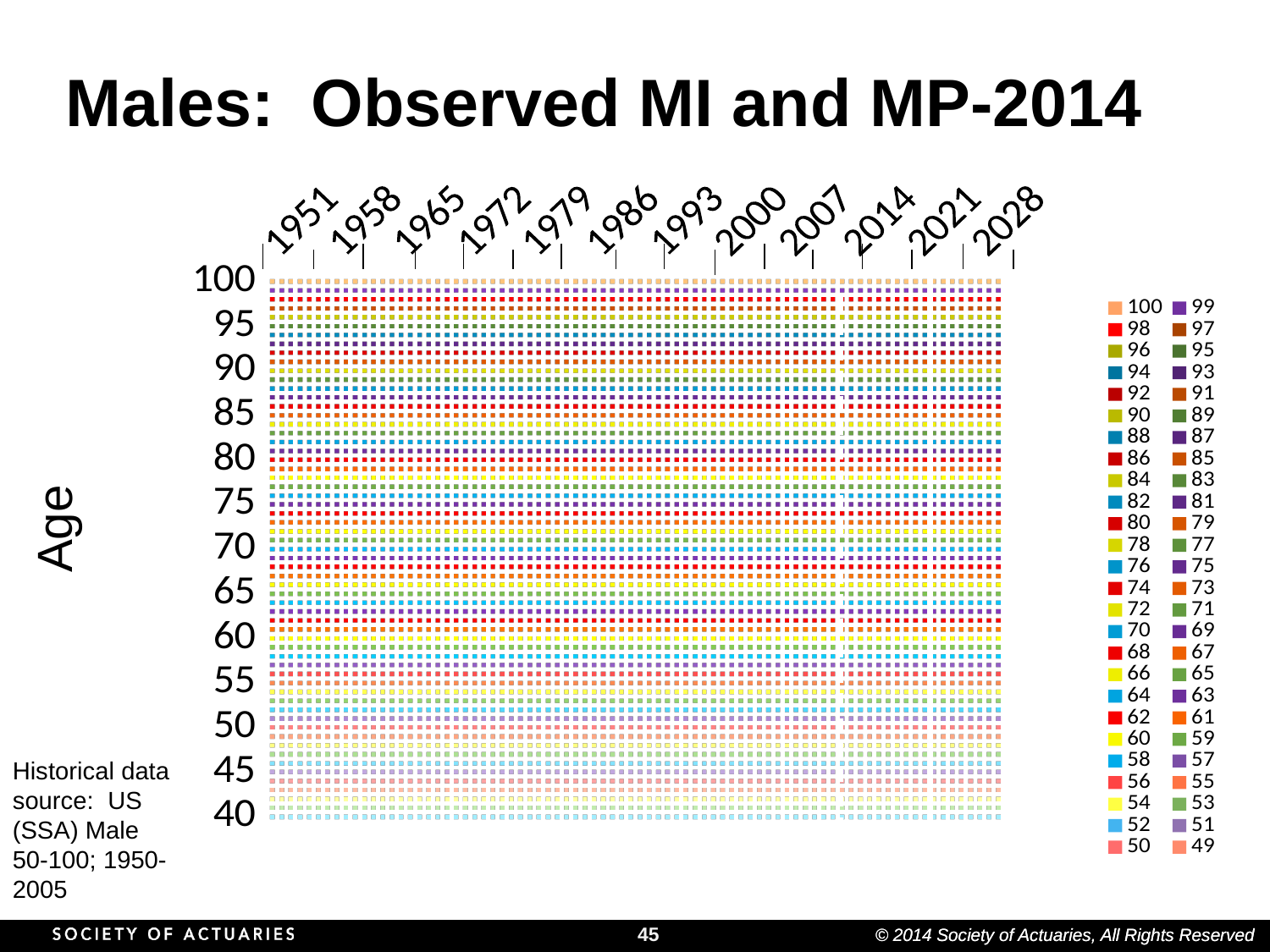
How many year labels are shown along the horizontal axis of the chart? 12 What is the title of the chart on the slide? Males: Observed MI and MP-2014 What is the highest age listed in the chart's legend? 100 What is the last year shown on the horizontal axis of the chart? 2028 What is the highest age shown on the vertical axis of the chart? 100 What is the lowest age shown on the vertical axis of the chart? 40 What is the lowest age listed in the chart's legend? 49 What is the first year shown on the horizontal axis of the chart? 1951 What kind of chart is shown on the slide? scatter chart What label is shown on the vertical axis of the chart? Age How many series does the chart's legend list? 52